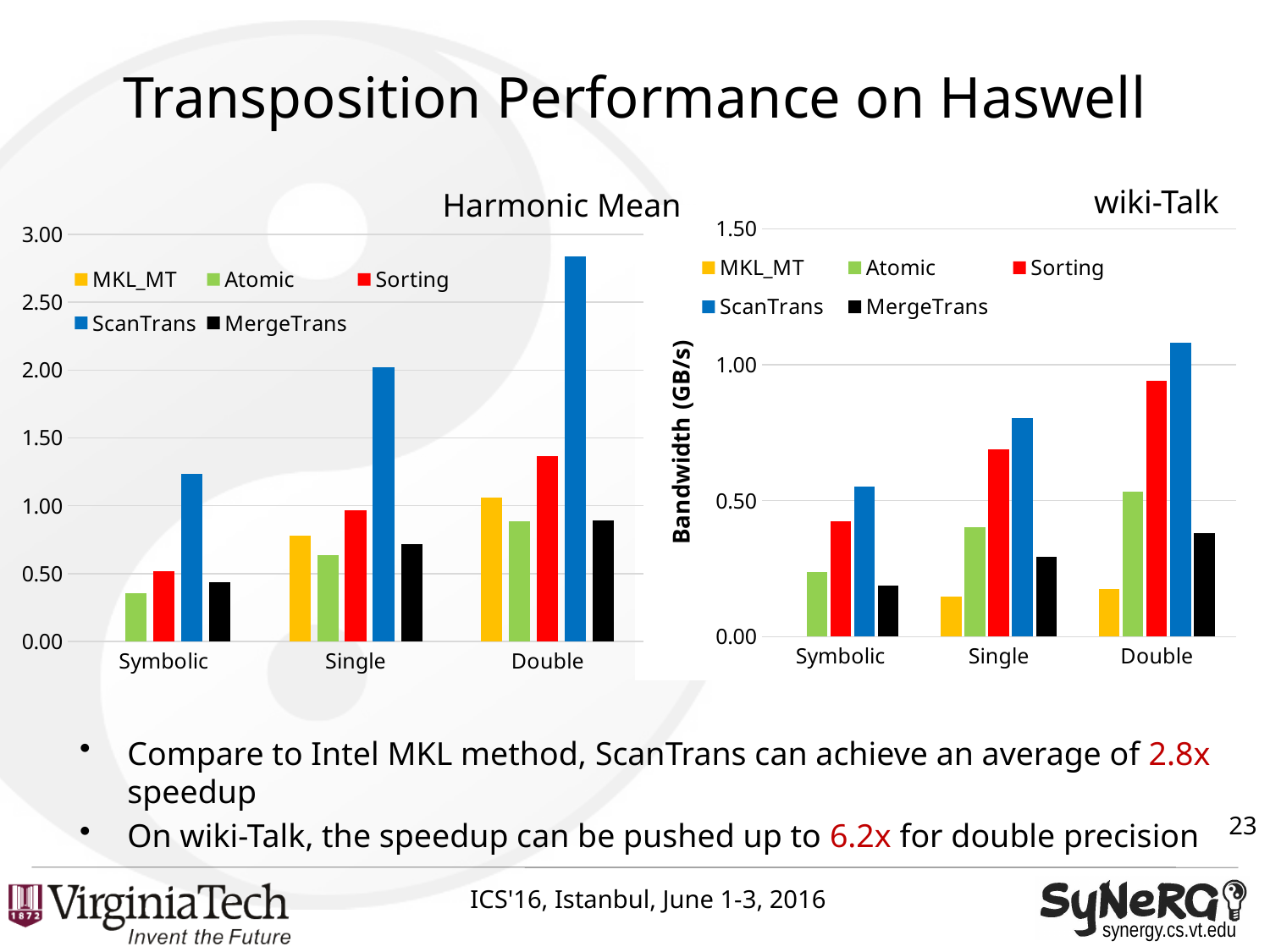
What is the y-axis label of the wiki-Talk chart? Bandwidth (GB/s) In the Harmonic Mean chart, is the ScanTrans value for Double greater or less than 2.50? greater In the wiki-Talk chart, does the ScanTrans value rise or fall from Symbolic to Double? rise How many categories are shown on the x axis of the Harmonic Mean chart? 3 What kind of chart is the Harmonic Mean chart on the left? bar chart In the Harmonic Mean chart, is the Atomic value for Symbolic greater or less than 0.50? less How many series does the legend of the wiki-Talk chart list? 5 In the Harmonic Mean chart, which series has the highest value for Double? ScanTrans In the wiki-Talk chart, is the Sorting value for Double greater or less than 1.00? less In the Harmonic Mean chart, which is larger for Double: Sorting or MergeTrans? Sorting In the wiki-Talk chart, which series has the lowest value for Double? MKL_MT